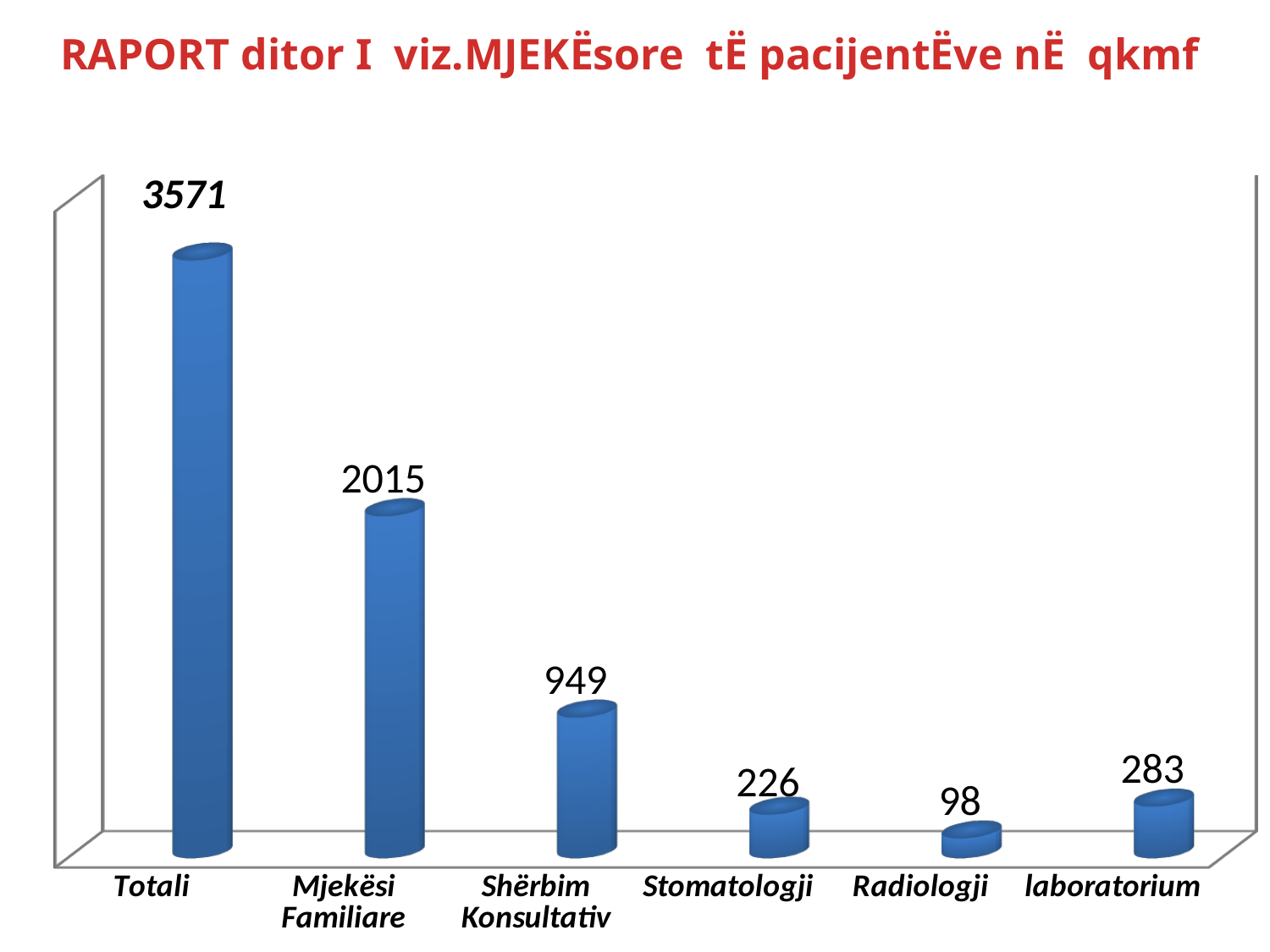
What kind of chart is shown on the slide? bar chart What is the value for Shërbim Konsultativ? 949 How many categories are shown on the x axis? 6 What is the difference between the values for Mjekësi Familiare and Shërbim Konsultativ? 1066 What is the difference between the values for laboratorium and Stomatologji? 57 What is the value for Radiologji? 98 Which is larger, the value for Stomatologji or the value for laboratorium? laboratorium Which category has the highest value? Totali Which category has the lowest value? Radiologji What is the value for Mjekësi Familiare? 2015 What is the value for Totali? 3571 What is the value for laboratorium? 283